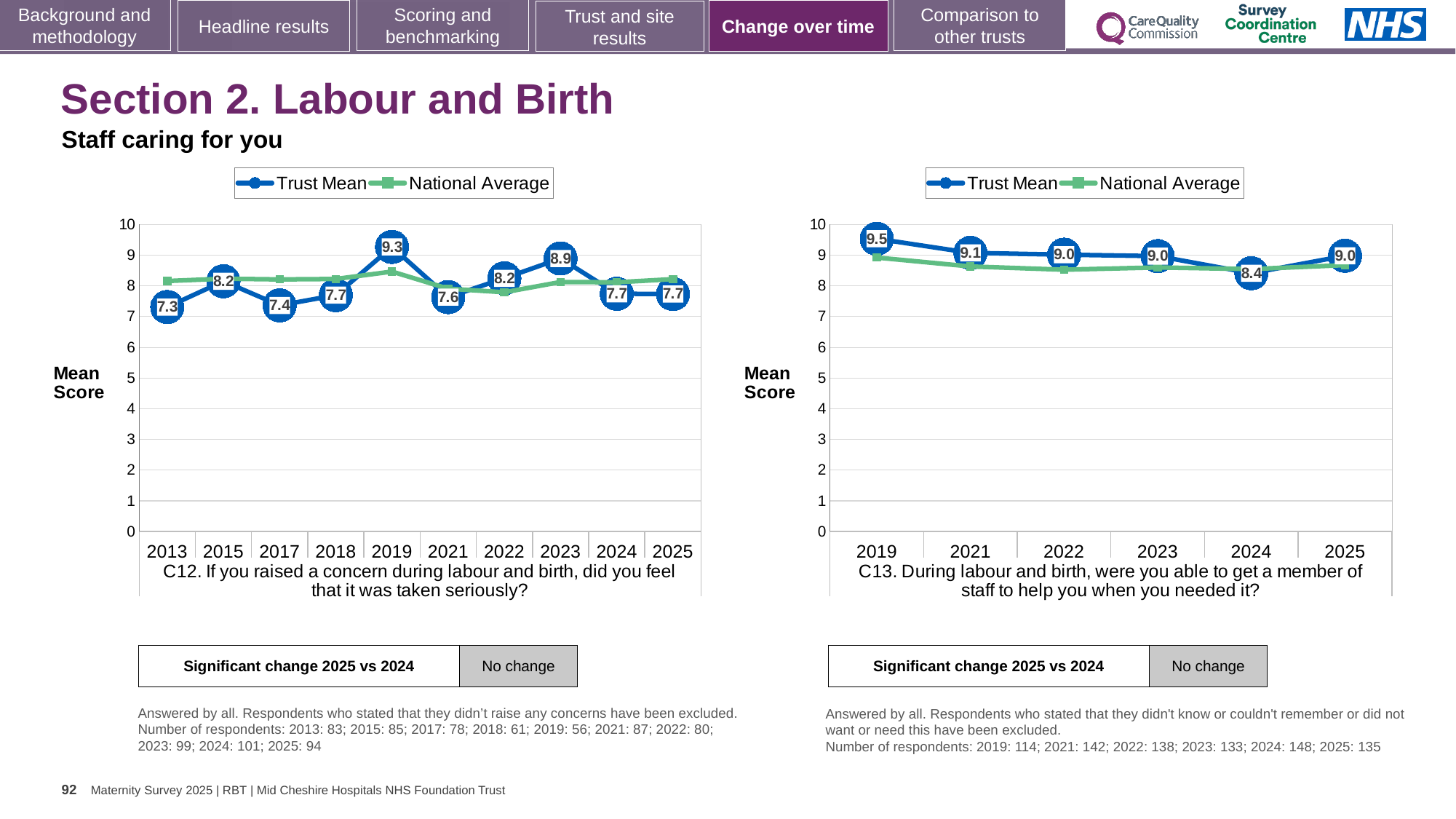
How many years are plotted on the right chart (C13)? 6 What kind of chart is the left chart (C12)? line chart On the left chart (C12), what is the difference between the Trust Mean in 2019 and in 2013? 2.0 How many series does the legend of the left chart (C12) list? 2 On the right chart (C13), what is the difference between the Trust Mean in 2019 and in 2024? 1.1 On the right chart (C13), which year has the highest Trust Mean? 2019 How many years are plotted on the left chart (C12)? 10 On the left chart (C12), what is the Trust Mean for 2019? 9.3 On the right chart (C13), what is the Trust Mean for 2024? 8.4 On the left chart (C12), which year has the highest Trust Mean? 2019 On the left chart (C12), which year has the lowest Trust Mean? 2013 On the right chart (C13), which year has the lowest Trust Mean? 2024